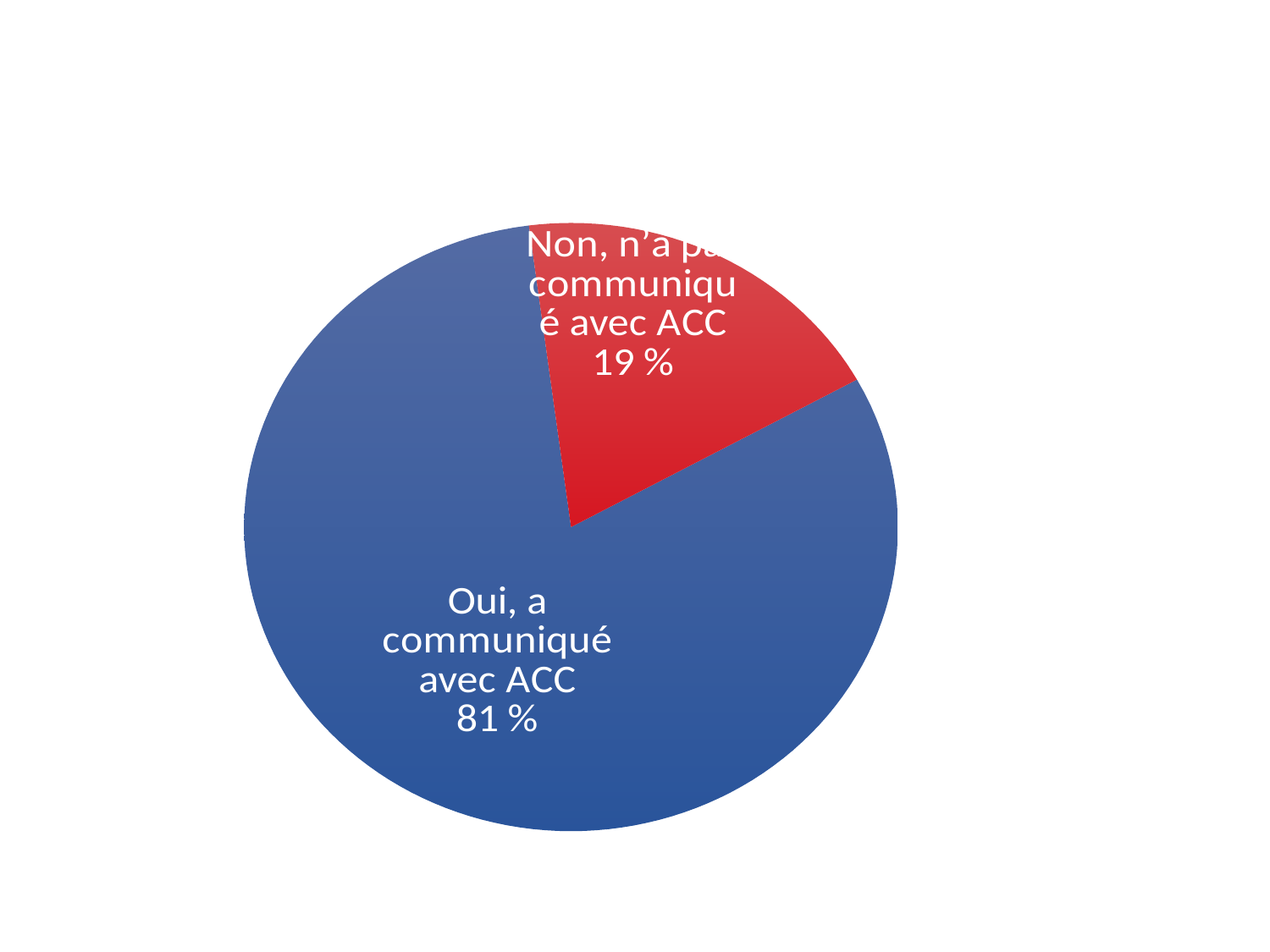
Which is larger: the share for "Oui, a communiqué avec ACC" or the share for "Non, n'a pas communiqué avec ACC"? Oui, a communiqué avec ACC What share of the pie is labelled "Non, n'a pas communiqué avec ACC"? 19 % Which slice of the pie is the largest? Oui, a communiqué avec ACC What share of the pie is labelled "Oui, a communiqué avec ACC"? 81 % Is the share for "Oui, a communiqué avec ACC" greater or less than 50 %? greater What colour is the slice for "Oui, a communiqué avec ACC"? blue What kind of chart is shown on the slide? pie chart Which slice of the pie is the smallest? Non, n'a pas communiqué avec ACC How many slices does the pie chart have? 2 What colour is the slice for "Non, n'a pas communiqué avec ACC"? red What is the difference in percentage points between the "Oui" slice and the "Non" slice? 62